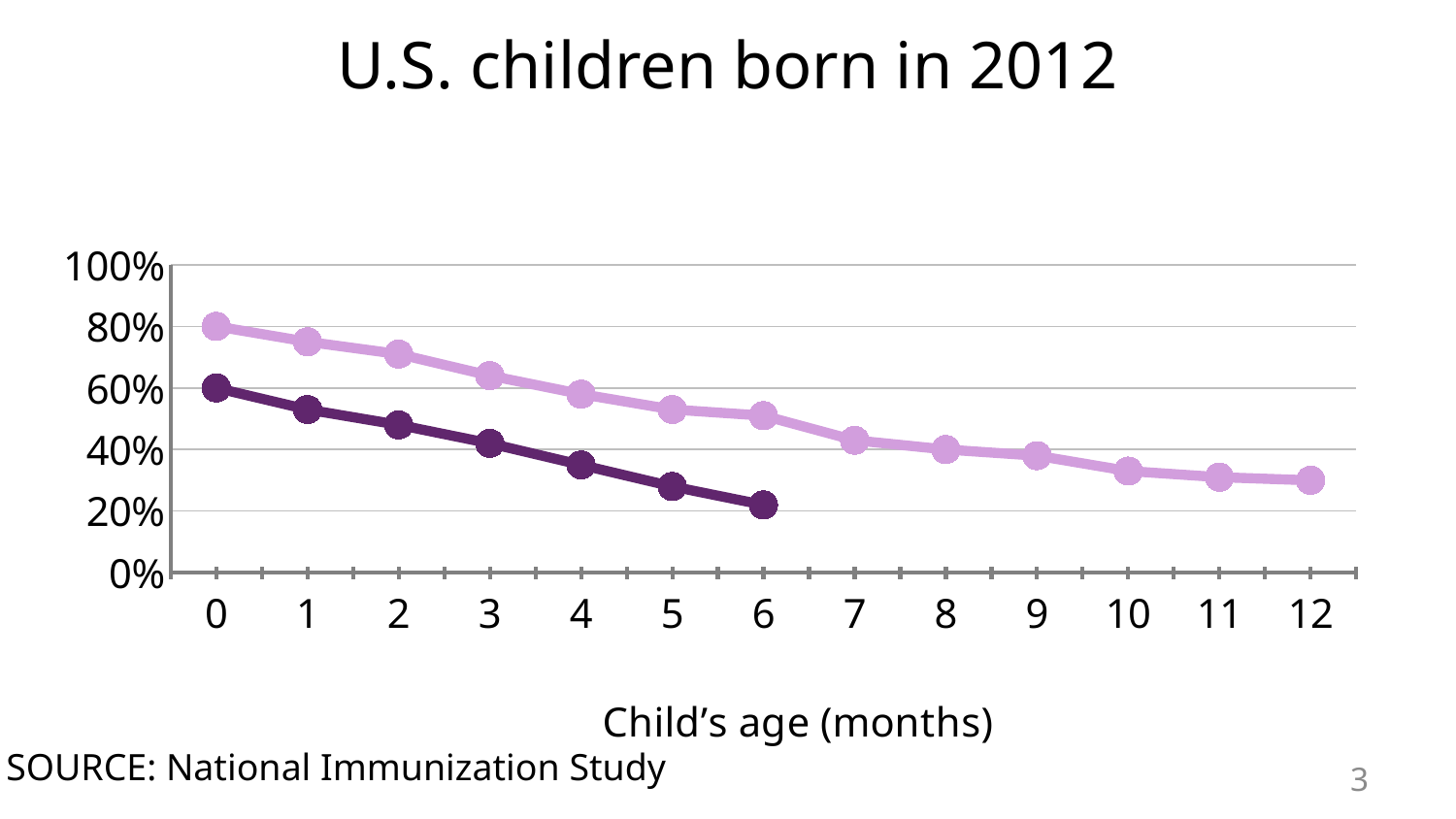
How many data points does the light purple line have? 13 How many lines are plotted on the chart? 2 Do the values of the light purple line rise or fall as the child's age increases? fall Is the value of the light purple line at 12 months greater or less than 20%? greater Is the value of the dark purple line at 6 months greater or less than 40%? less At 3 months, which line has the higher value, the light purple line or the dark purple line? the light purple line What is the label of the x axis? Child's age (months) What is the value of the dark purple line at 0 months? 60% How many data points does the dark purple line have? 7 What is the value of the light purple line at 0 months? 80% What kind of chart is shown on the slide? line chart What is the title of the chart? U.S. children born in 2012